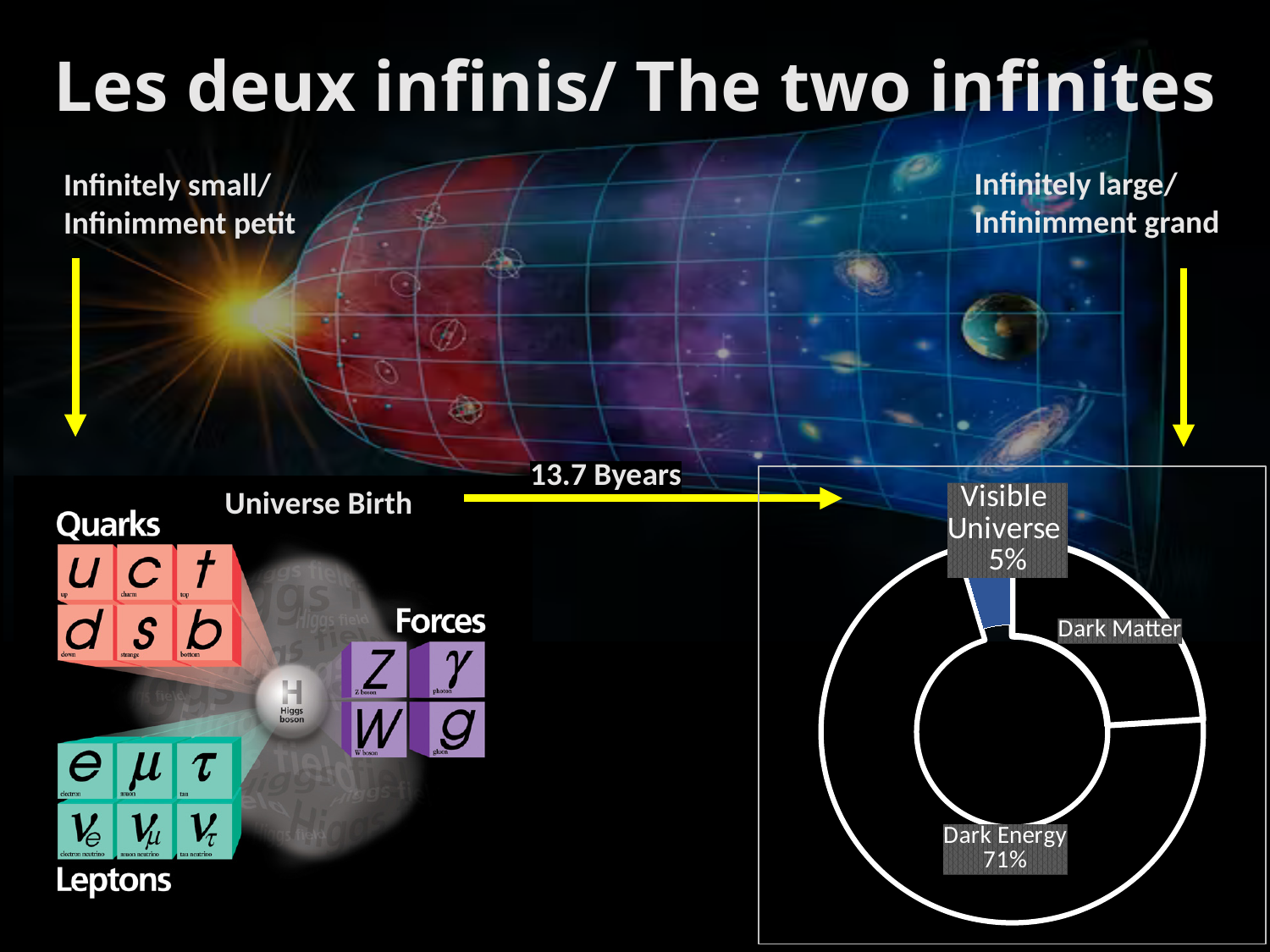
What percentage of the doughnut chart is labelled Visible Universe? 5% Which category has the largest slice in the doughnut chart? Dark Energy Which slice is larger in the doughnut chart, Dark Energy or Dark Matter? Dark Energy What share of the doughnut chart does the Dark Energy slice represent? 71% Which slice is larger in the doughnut chart, Dark Matter or Visible Universe? Dark Matter How many categories are shown in the doughnut chart? 3 Which category has the smallest slice in the doughnut chart? Visible Universe What colour is the Visible Universe slice in the doughnut chart? Blue What percentage of the doughnut chart is labelled Dark Energy? 71% What share of the doughnut chart does the Visible Universe slice represent? 5% What is the difference in percentage points between the Dark Energy slice and the Visible Universe slice? 66% What kind of chart is shown on the right side of the slide? Doughnut (pie) chart